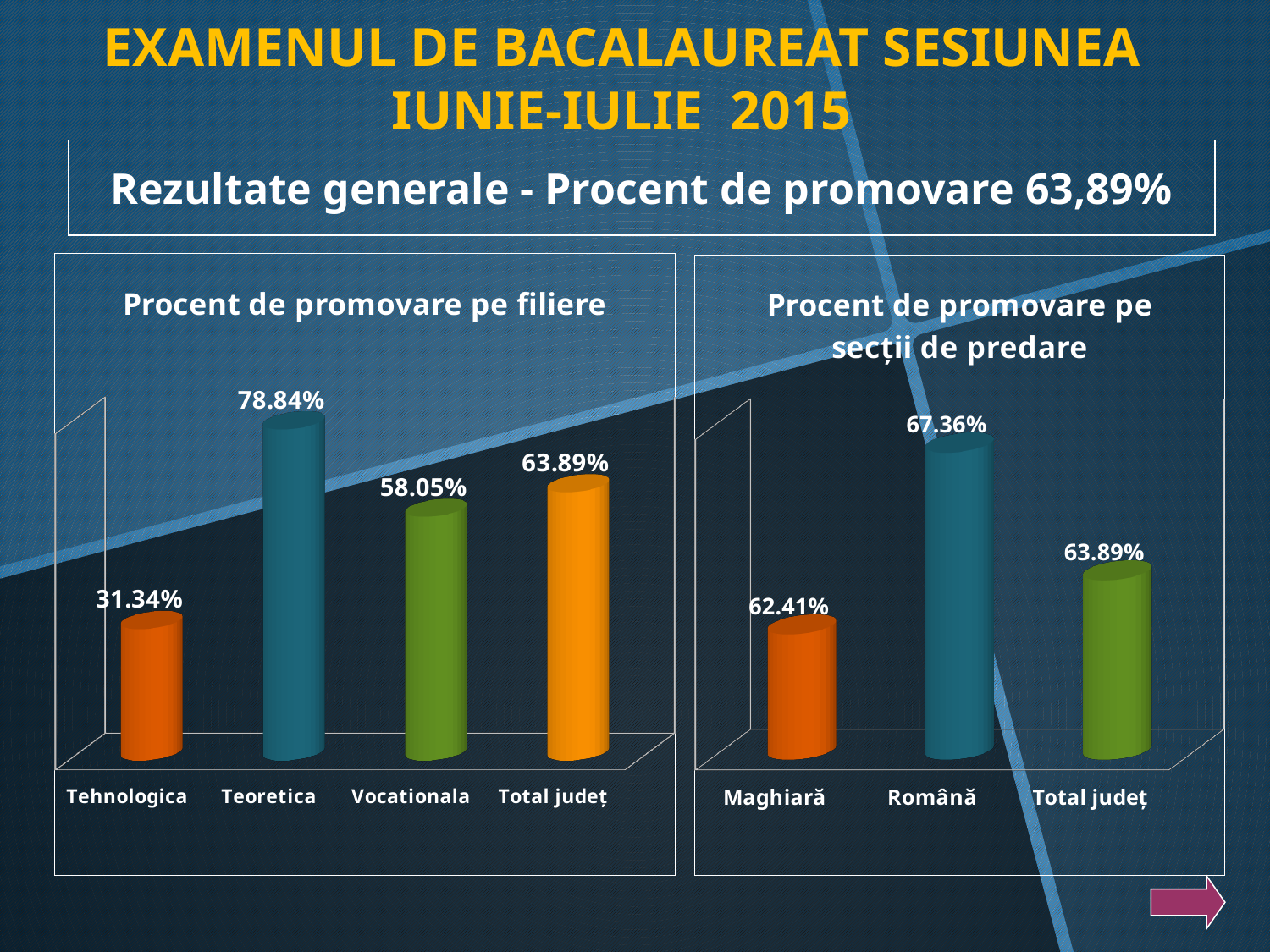
In the chart titled "Procent de promovare pe filiere", which category has the highest value? Teoretica In the chart titled "Procent de promovare pe filiere", which category has the lowest value? Tehnologica In the chart titled "Procent de promovare pe secții de predare", what is the difference between the values for Română and Maghiară? 4.95% In the chart titled "Procent de promovare pe secții de predare", which is larger, the value for Maghiară or the value for Română? Română What kind of chart is the chart on the left of the slide? Bar chart In the chart titled "Procent de promovare pe filiere", how many categories are shown? 4 In the chart titled "Procent de promovare pe filiere", what is the value for Tehnologica? 31.34% In the chart titled "Procent de promovare pe secții de predare", how many categories are shown? 3 In the chart titled "Procent de promovare pe filiere", what is the difference between the values for Teoretica and Tehnologica? 47.50% In the chart titled "Procent de promovare pe filiere", what is the value for Vocationala? 58.05% In the chart titled "Procent de promovare pe secții de predare", what is the value for Română? 67.36% In the chart titled "Procent de promovare pe secții de predare", what is the value for Maghiară? 62.41%